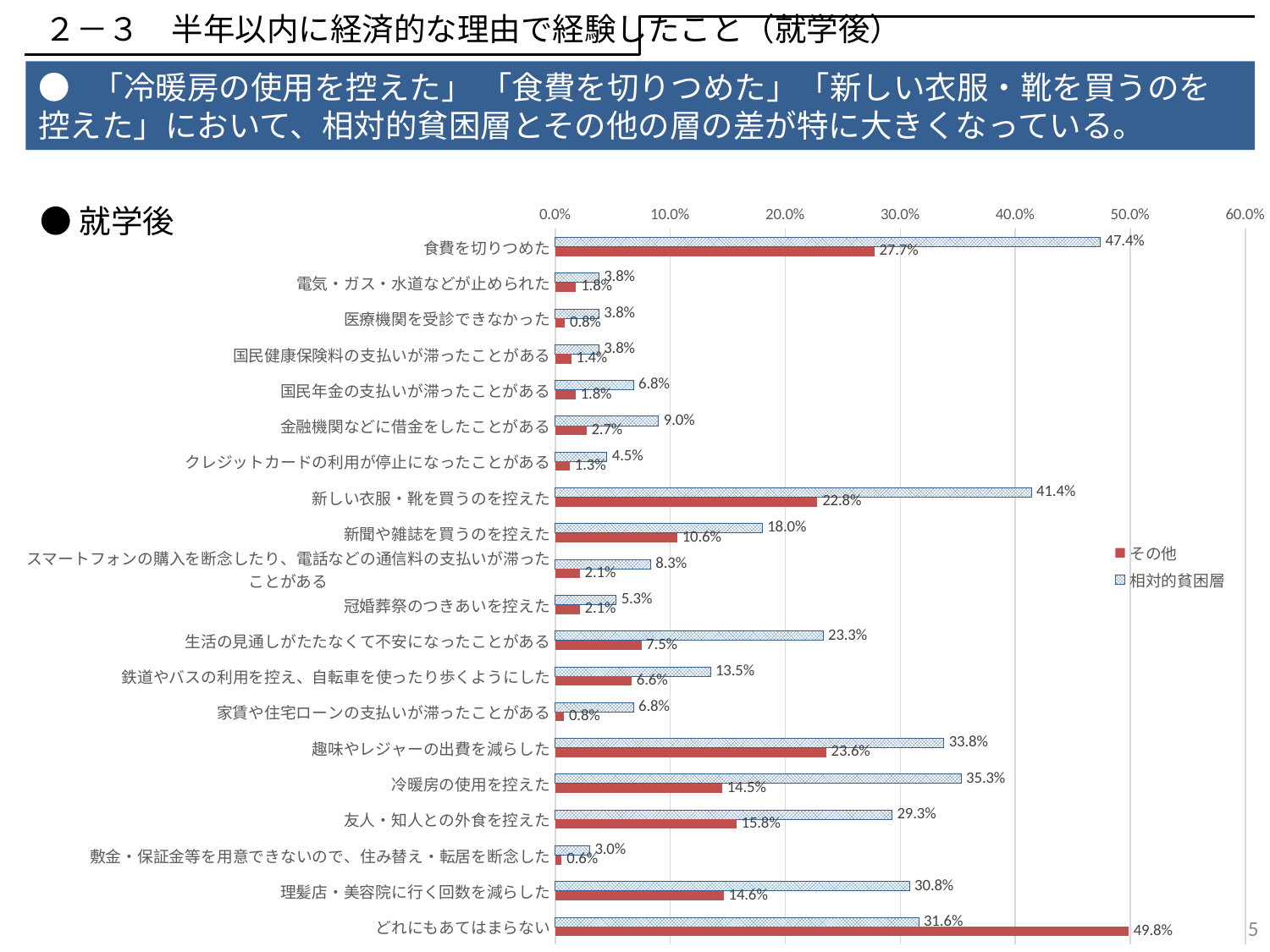
How many categories are plotted on the chart? 20 Which category has the lowest value for the 相対的貧困層 series? 敷金・保証金等を用意できないので、住み替え・転居を断念した How many series does the legend list? 2 Which series is shown in red in the legend? その他 What is the difference between 相対的貧困層 and その他 in the category 冷暖房の使用を控えた? 20.8 percentage points What is the value for その他 in the category 冷暖房の使用を控えた? 14.5% In the category どれにもあてはまらない, which series has the larger value, その他 or 相対的貧困層? その他 What is the value for 相対的貧困層 in the category 新しい衣服・靴を買うのを控えた? 41.4% What is the value for 相対的貧困層 in the category 食費を切りつめた? 47.4% What type of chart is shown on the slide? Bar chart Which category has the highest value for the その他 series? どれにもあてはまらない Is the value for 相対的貧困層 in the category 趣味やレジャーの出費を減らした greater or less than 30.0%? greater